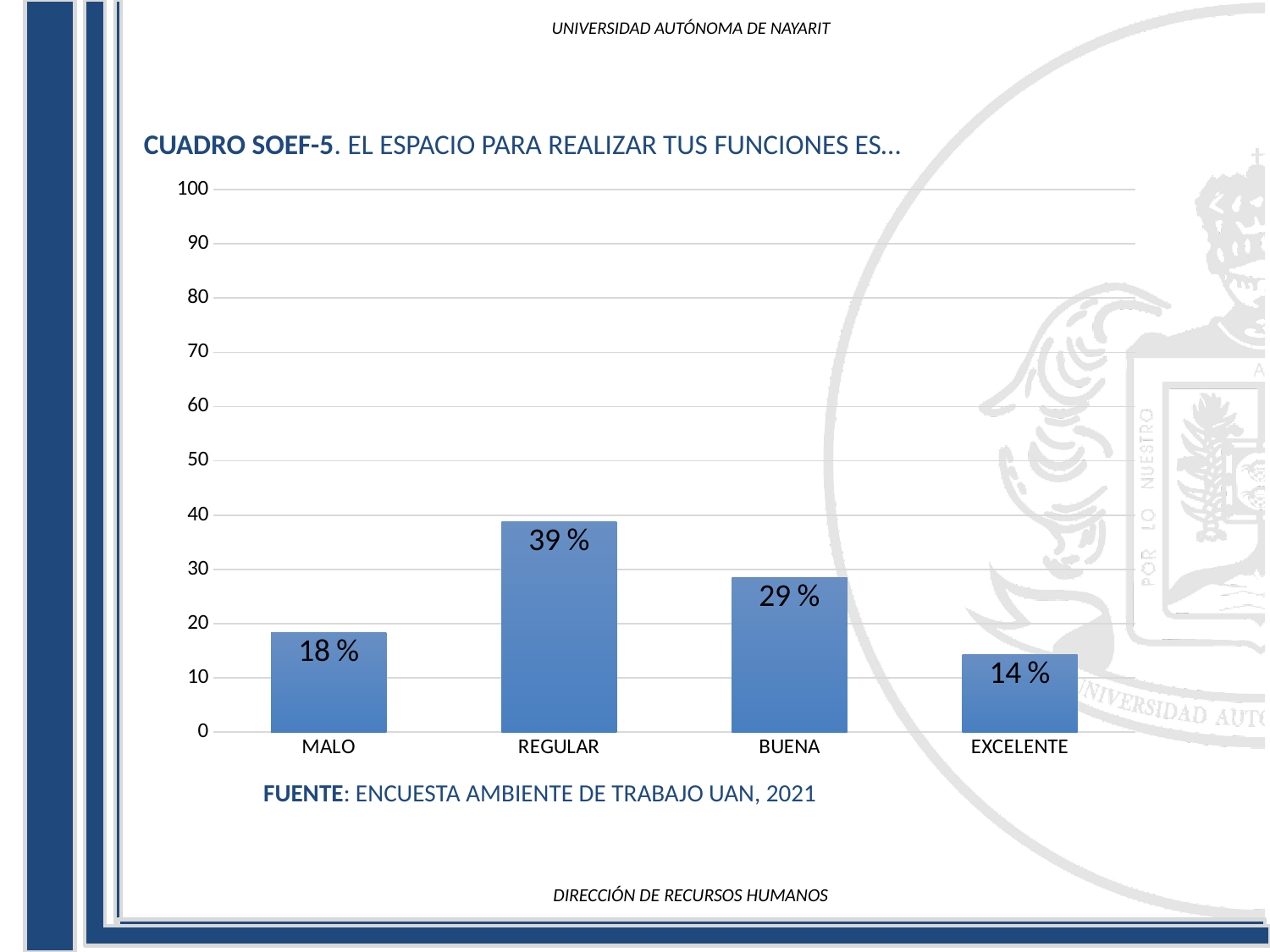
What kind of chart is shown on the slide? bar chart Is the value for BUENA greater or less than 20? greater How many categories are shown on the x axis? 4 Which category has the lowest value? EXCELENTE Which is larger, the value for MALO or the value for BUENA? BUENA What is the value for REGULAR? 39 % What is the title of the chart? CUADRO SOEF-5. EL ESPACIO PARA REALIZAR TUS FUNCIONES ES… Which category has the highest value? REGULAR What is the difference between the values for REGULAR and BUENA? 10 % What is the value for EXCELENTE? 14 % What source is cited below the chart? ENCUESTA AMBIENTE DE TRABAJO UAN, 2021 What is the value for MALO? 18 %